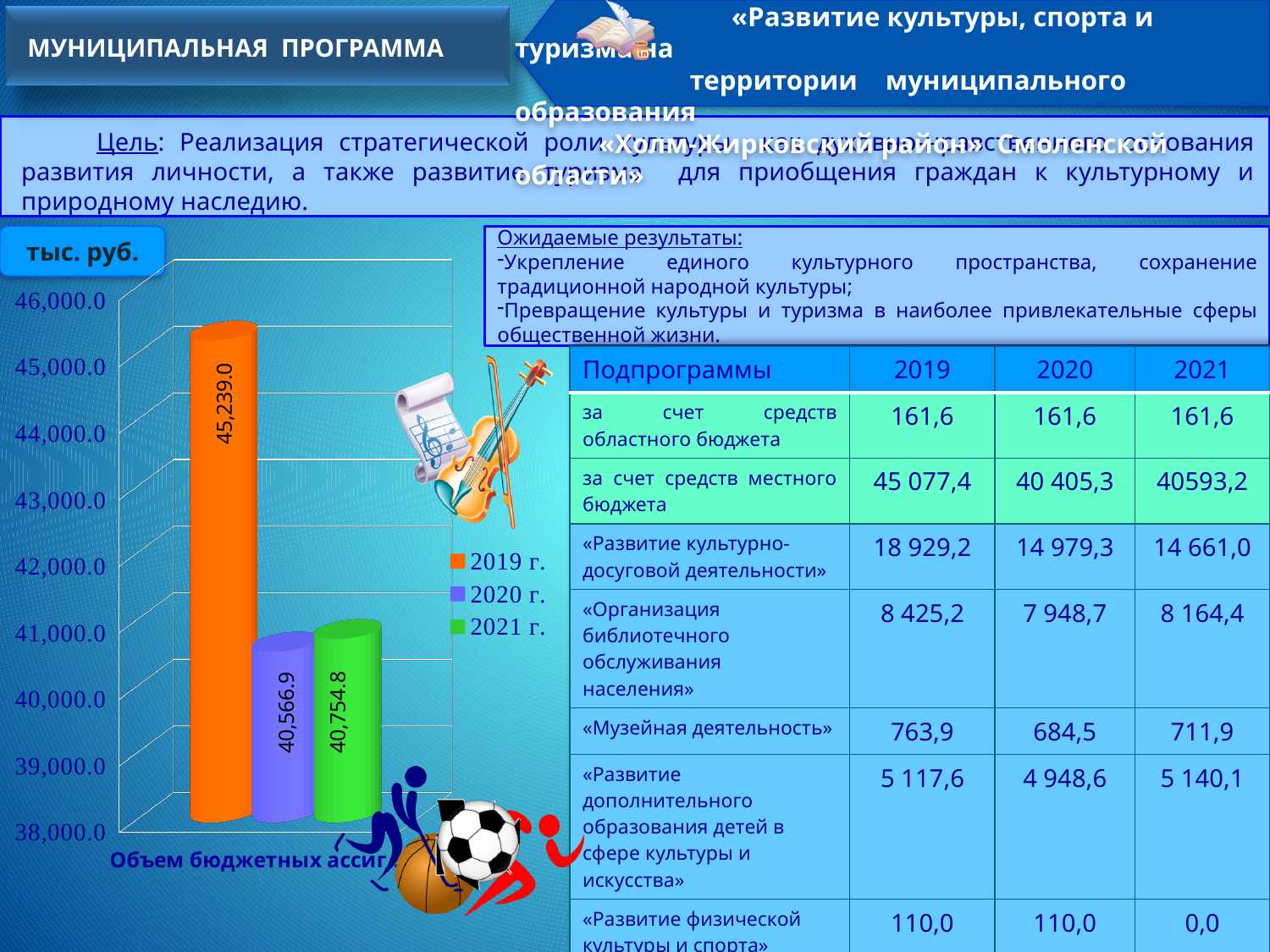
Is the value for 2019 г. greater or less than 44,000.0? greater Which is larger in the chart, the value for 2020 г. or for 2021 г.? 2021 г. How many series does the chart legend list? 3 What is the difference between the 2021 г. and 2020 г. values in the chart? 187.9 What type of chart is shown on the slide? bar chart Which year has the highest value in the chart? 2019 г. What is the value of the 2019 г. bar in the chart? 45,239.0 What is the difference between the 2019 г. and 2020 г. values in the chart? 4,672.1 Which year has the lowest value in the chart? 2020 г. What is the value of the 2021 г. bar in the chart? 40,754.8 Is the value for 2020 г. greater or less than 41,000.0? less What is the value of the 2020 г. bar in the chart? 40,566.9